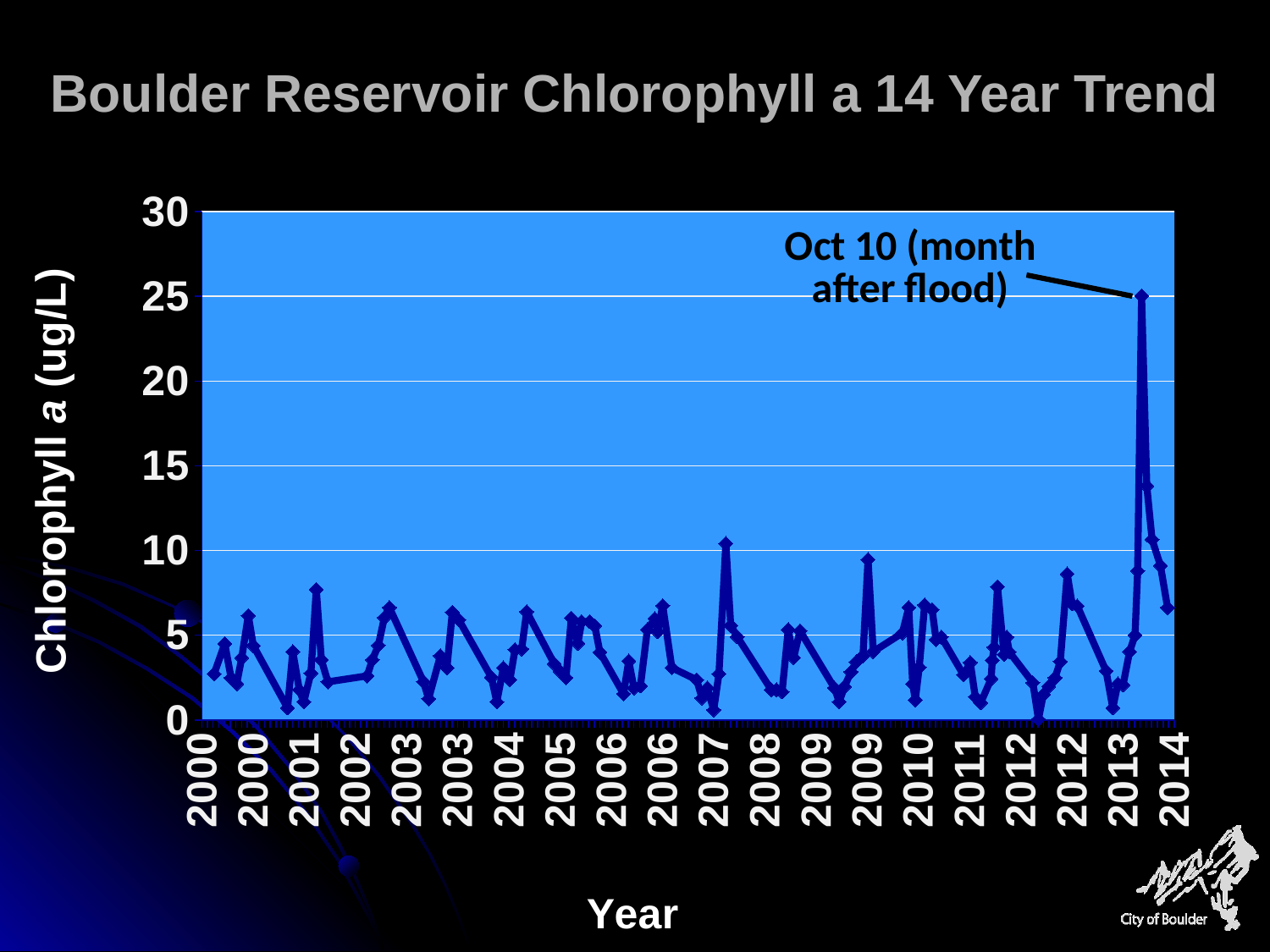
What is the label of the y axis? Chlorophyll a (ug/L) Is the highest value in 2001 greater or less than 10? less What is the first year shown on the x axis? 2000 Is the value for the Oct 10 (month after flood) point greater or less than 20? greater Is the highest value in 2009 greater or less than 5? greater Which data point is annotated as the highest chlorophyll a value on the chart? Oct 10 (month after flood) What is the title of the chart? Boulder Reservoir Chlorophyll a 14 Year Trend Which is larger, the peak value in 2013 or the peak value in 2007? 2013 What kind of chart is shown on the slide? line chart What is the last year shown on the x axis? 2014